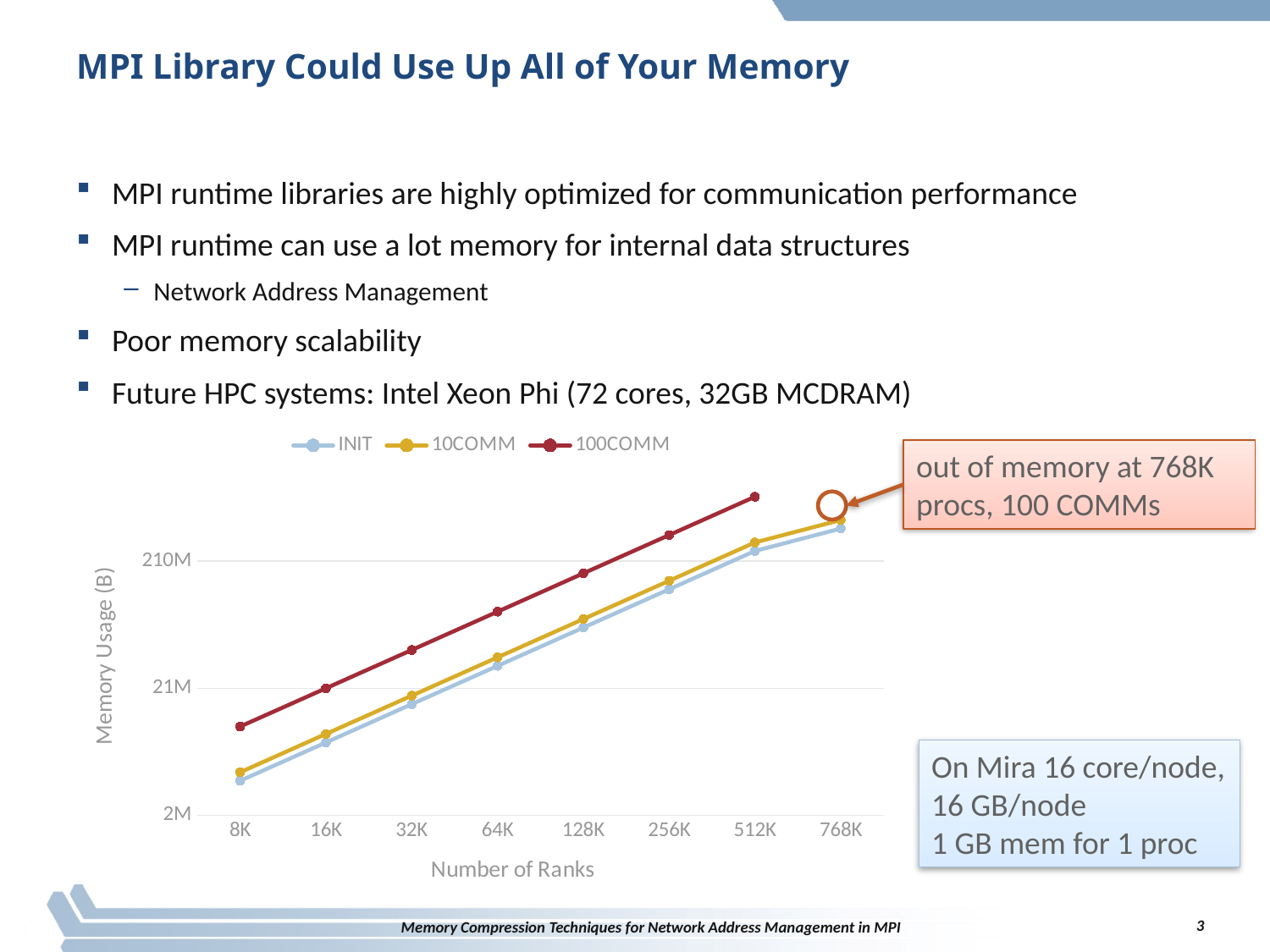
Which series has the lowest memory usage at 512K ranks? INIT How many rank counts are labelled along the x axis of the chart? 8 Which series has the highest memory usage at 8K ranks? 100COMM What is the title of the chart's y axis? Memory Usage (B) What kind of chart is shown on the slide? line chart How many series does the chart legend list? 3 Is the memory usage for 100COMM at 8K ranks greater or less than 21M? less Is the memory usage for 10COMM at 128K ranks greater or less than 210M? less What is the title of the chart's x axis? Number of Ranks Does memory usage rise or fall as the number of ranks increases? rise Which is larger at 64K ranks, the memory usage for 100COMM or for INIT? 100COMM Is the memory usage for 100COMM at 512K ranks greater or less than 210M? greater